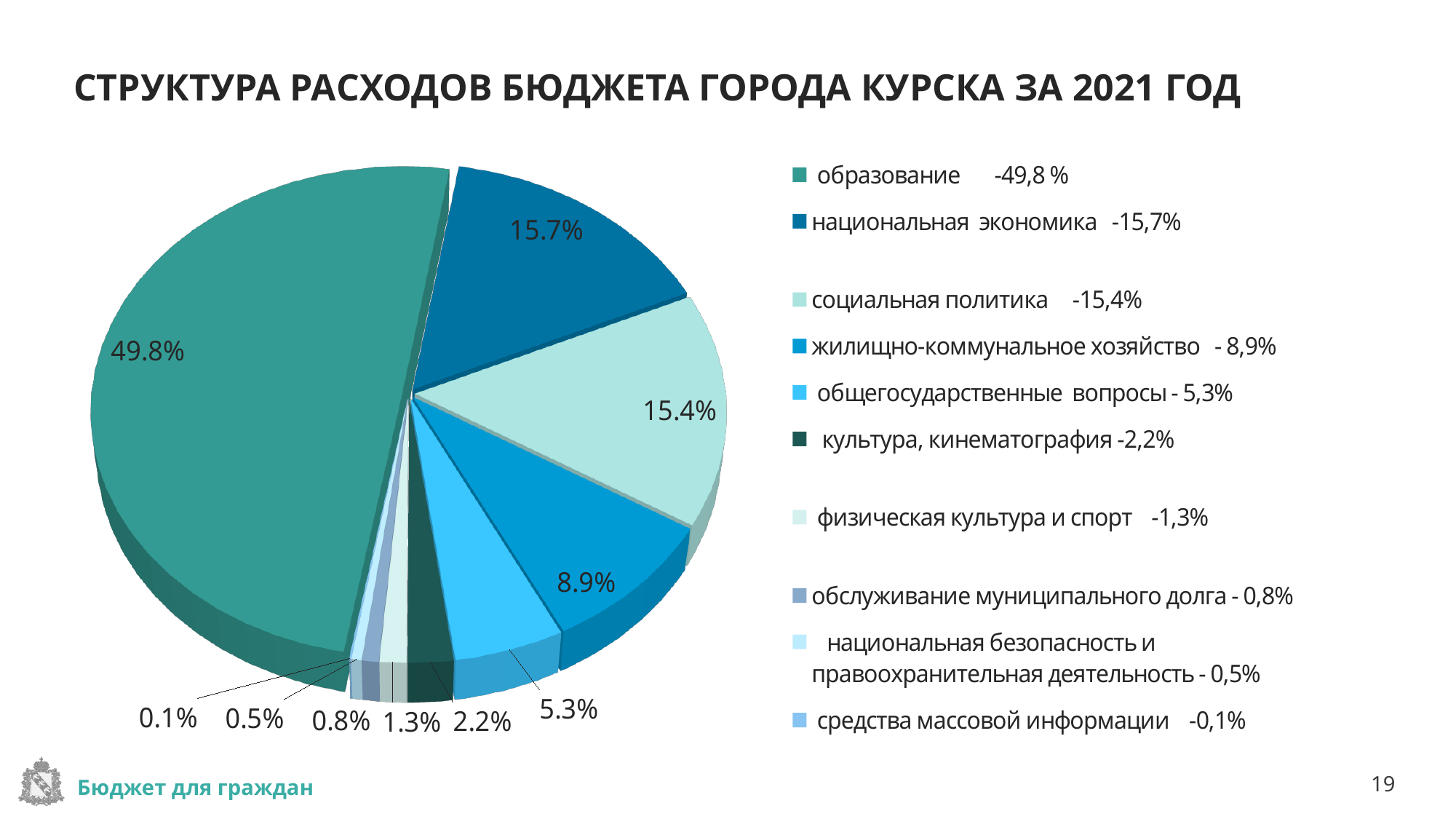
Which category has the smallest share of the pie? средства массовой информации What is the title of the chart on the slide? СТРУКТУРА РАСХОДОВ БЮДЖЕТА ГОРОДА КУРСКА ЗА 2021 ГОД What is the value shown for общегосударственные вопросы? 5.3% Which category has the largest share of the pie? образование What is the value shown for культура, кинематография? 2.2% What is the difference in percentage points between образование and национальная экономика? 34.1 How many categories does the pie chart have? 10 What share of the pie does национальная экономика have? 15.7% What is the value shown for жилищно-коммунальное хозяйство? 8.9% What is the difference in percentage points between национальная экономика and социальная политика? 0.3 Which is larger: социальная политика or жилищно-коммунальное хозяйство? социальная политика What kind of chart is shown on the slide? pie chart